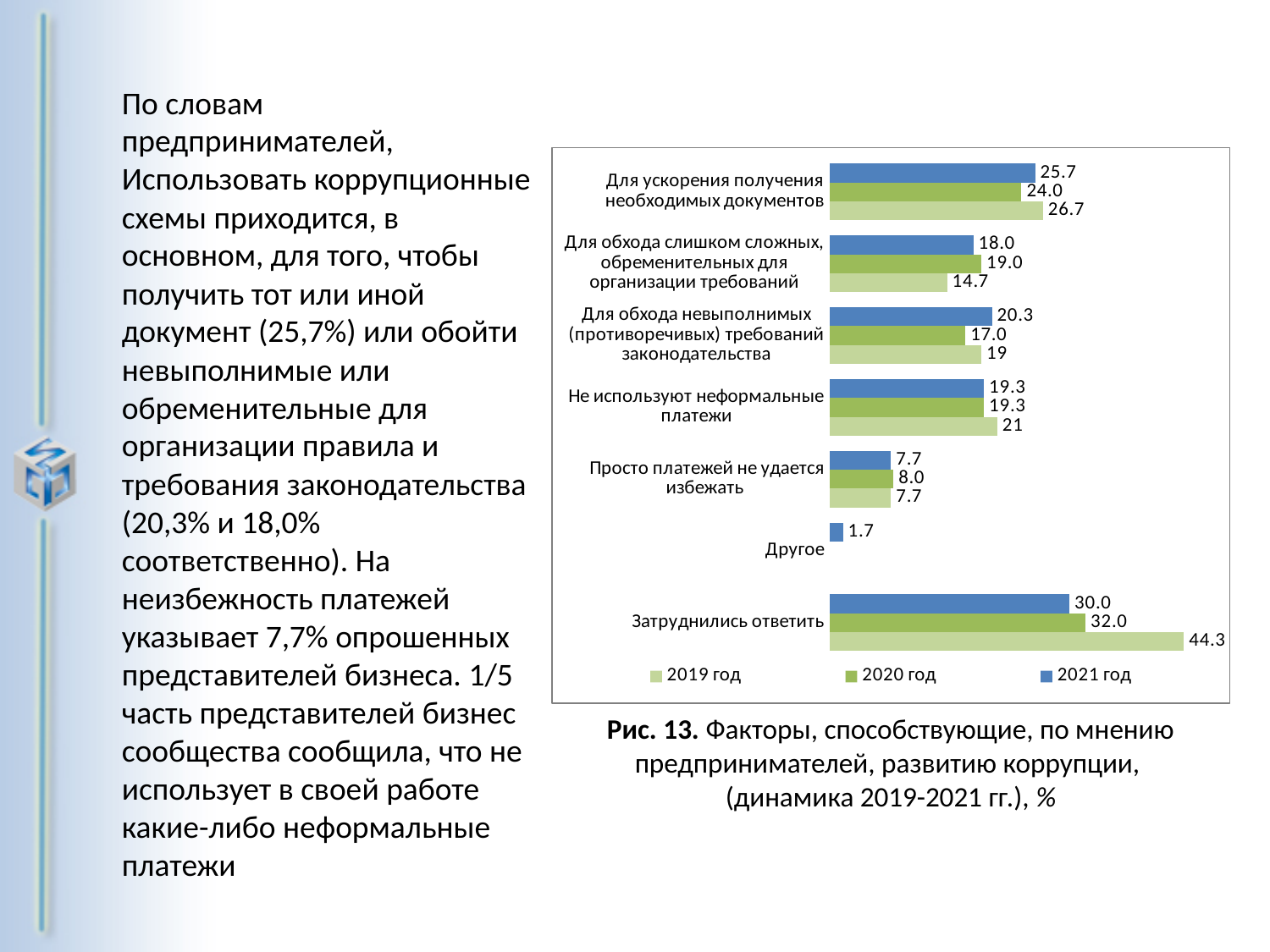
Which series is shown in dark blue in the legend? 2021 год How many series does the legend list? 3 What is the value for 2019 год for 'Затруднились ответить'? 44.3 How many categories are shown on the chart? 7 Which category has the lowest value for 2021 год? Другое Which category has the highest value for 2021 год? Затруднились ответить What is the value for 2021 год for 'Для ускорения получения необходимых документов'? 25.7 What is the value for 2020 год for 'Для обхода невыполнимых (противоречивых) требований законодательства'? 17.0 What is the value for 2021 год for 'Просто платежей не удается избежать'? 7.7 What type of chart is shown on the slide? bar chart What is the difference between the 2019 год and 2021 год values for 'Затруднились ответить'? 14.3 Which is larger for 'Для обхода слишком сложных, обременительных для организации требований': the 2020 год value or the 2019 год value? 2020 год